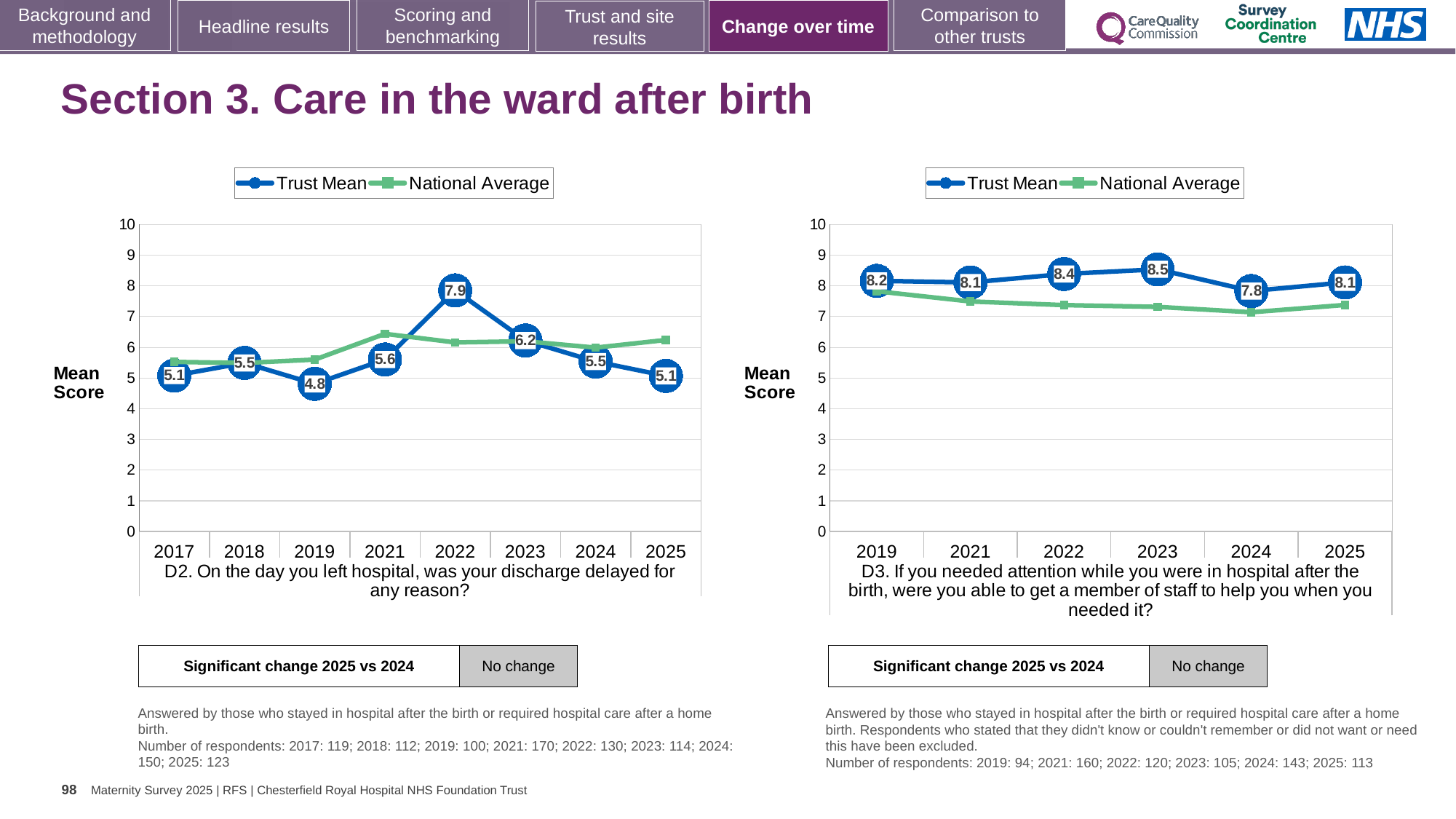
In the D2 chart (left), which year has the lowest Trust Mean? 2019 In the D2 chart (left), which year has the highest Trust Mean? 2022 In the D3 chart (right), how many series does the legend list? 2 In the D2 chart (left), what is the Trust Mean for 2022? 7.9 In the D3 chart (right), which year has the lowest Trust Mean? 2024 In the D2 chart (left), what is the difference between the Trust Mean for 2022 and the Trust Mean for 2023? 1.7 What kind of chart is the D2 chart on the left? Line chart In the D3 chart (right), what is the Trust Mean for 2023? 8.5 In the D3 chart (right), is the Trust Mean for 2022 or for 2024 larger? 2022 In the D2 chart (left), how many years are shown on the x axis? 8 In the D2 chart (left), what is the Trust Mean for 2019? 4.8 In the D3 chart (right), is the National Average for 2024 greater or less than 8? less